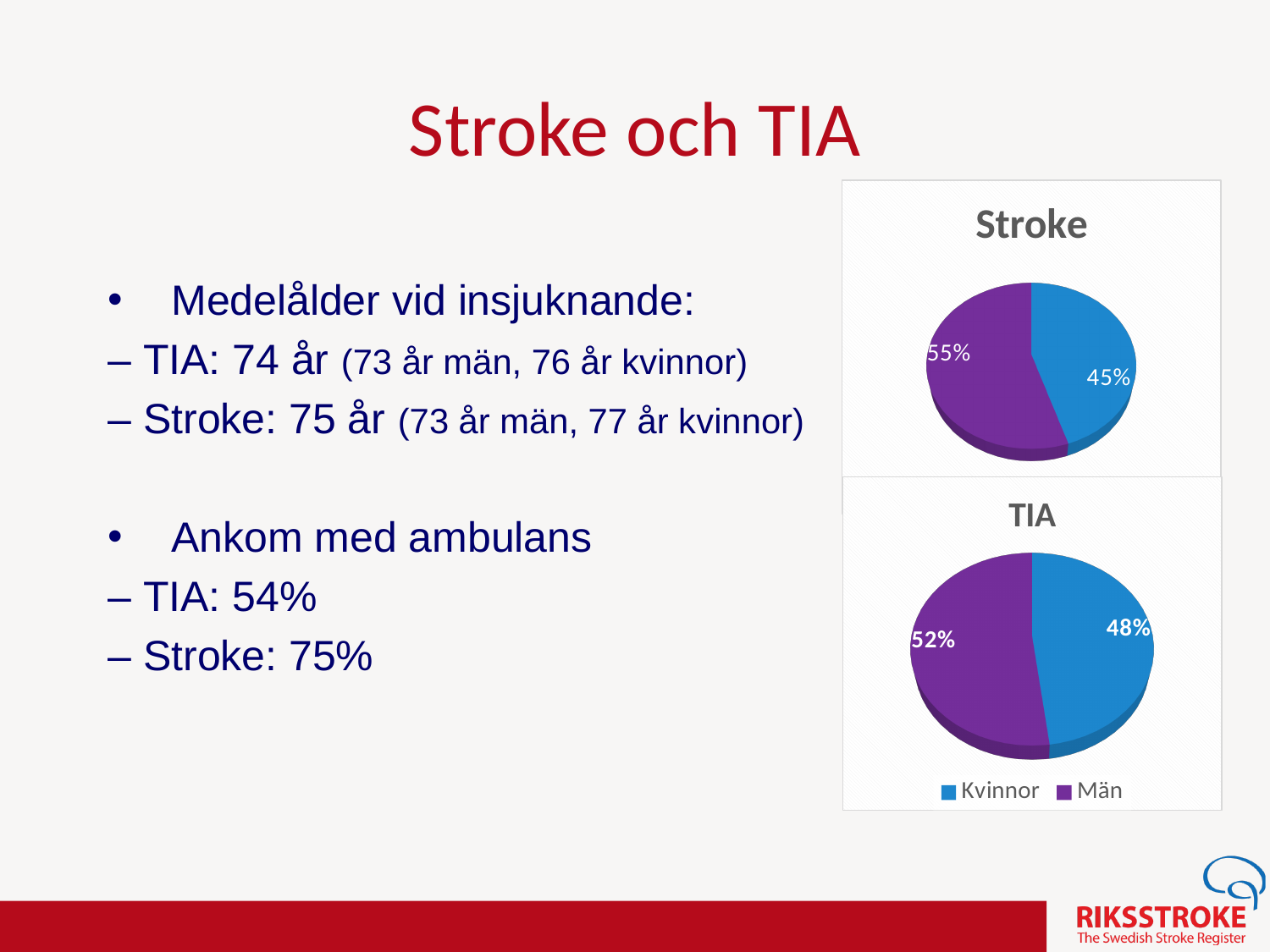
What kind of chart is the "Stroke" chart? pie chart How many slices does the "TIA" pie chart have? 2 In the "Stroke" chart, what is the smaller slice's labelled share? 45% In the "TIA" chart, what is the difference between the Män and Kvinnor percentages? 4% In the "TIA" chart, what share is labelled for Män? 52% How many entries does the legend below the "TIA" chart list? 2 In the legend below the "TIA" chart, which colour represents Kvinnor? blue What kind of chart is the "TIA" chart? pie chart In the "Stroke" chart, what is the larger slice's labelled share? 55% In the "Stroke" chart, what is the difference between the two slices' percentages? 10% In the "TIA" chart, which group has the larger slice, Kvinnor or Män? Män